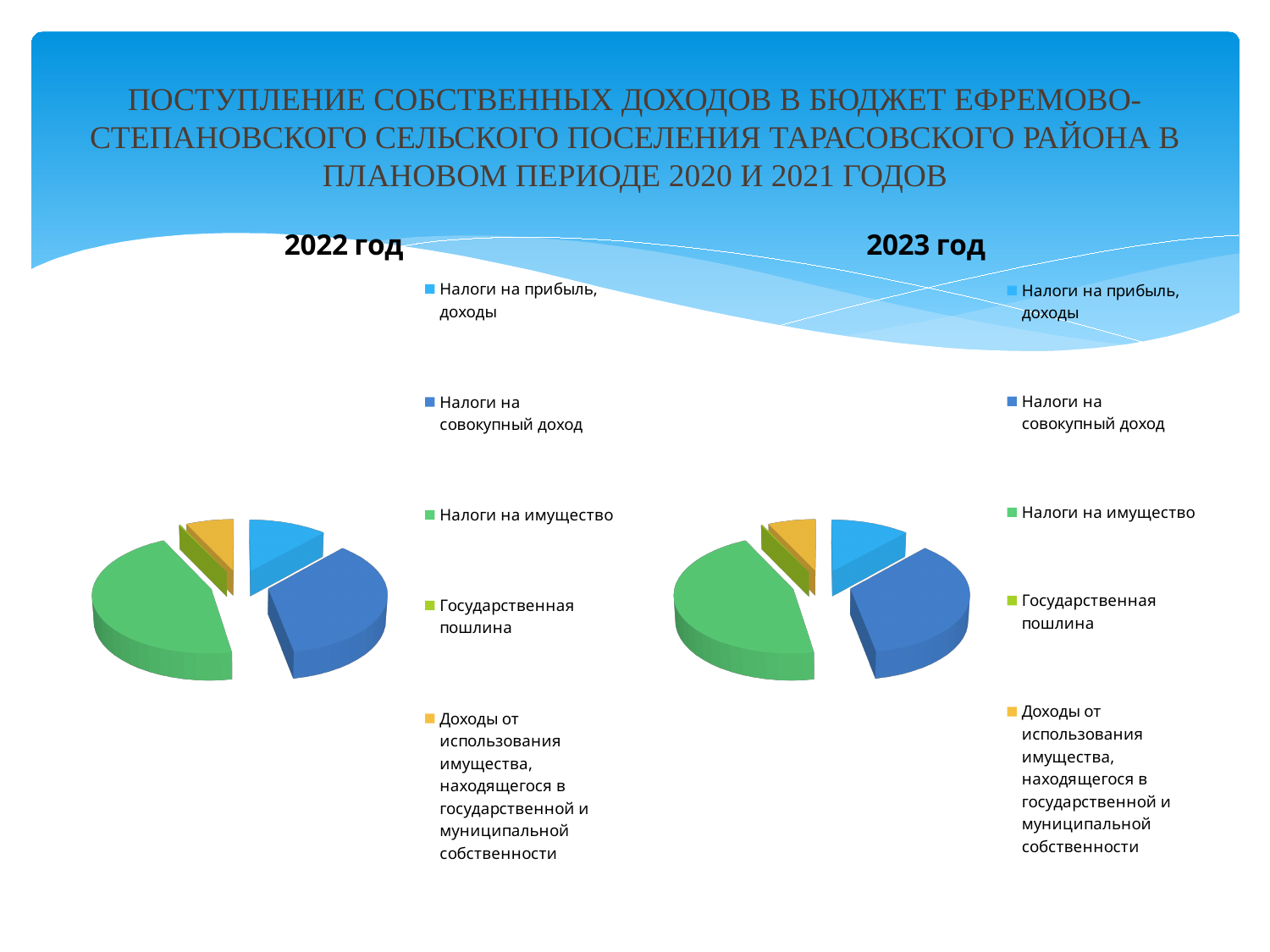
In the "2022 год" chart, which category has the largest slice? Налоги на имущество How many slices does the "2022 год" pie chart have? 5 In the "2023 год" chart, which slice is larger: "Налоги на имущество" or "Налоги на совокупный доход"? Налоги на имущество In the "2022 год" chart, what colour is the slice for "Налоги на имущество"? green In the "2022 год" chart, which category has the smallest slice? Государственная пошлина In the "2023 год" chart, which category has the largest slice? Налоги на имущество What kind of chart is the "2023 год" chart? pie chart What kind of chart is the "2022 год" chart? pie chart What are the titles of the two pie charts on the slide? 2022 год and 2023 год How many entries does the legend of the "2023 год" chart list? 5 In the "2022 год" chart, which slice is larger: "Налоги на совокупный доход" or "Налоги на прибыль, доходы"? Налоги на совокупный доход In the "2023 год" chart, which category has the smallest slice? Государственная пошлина